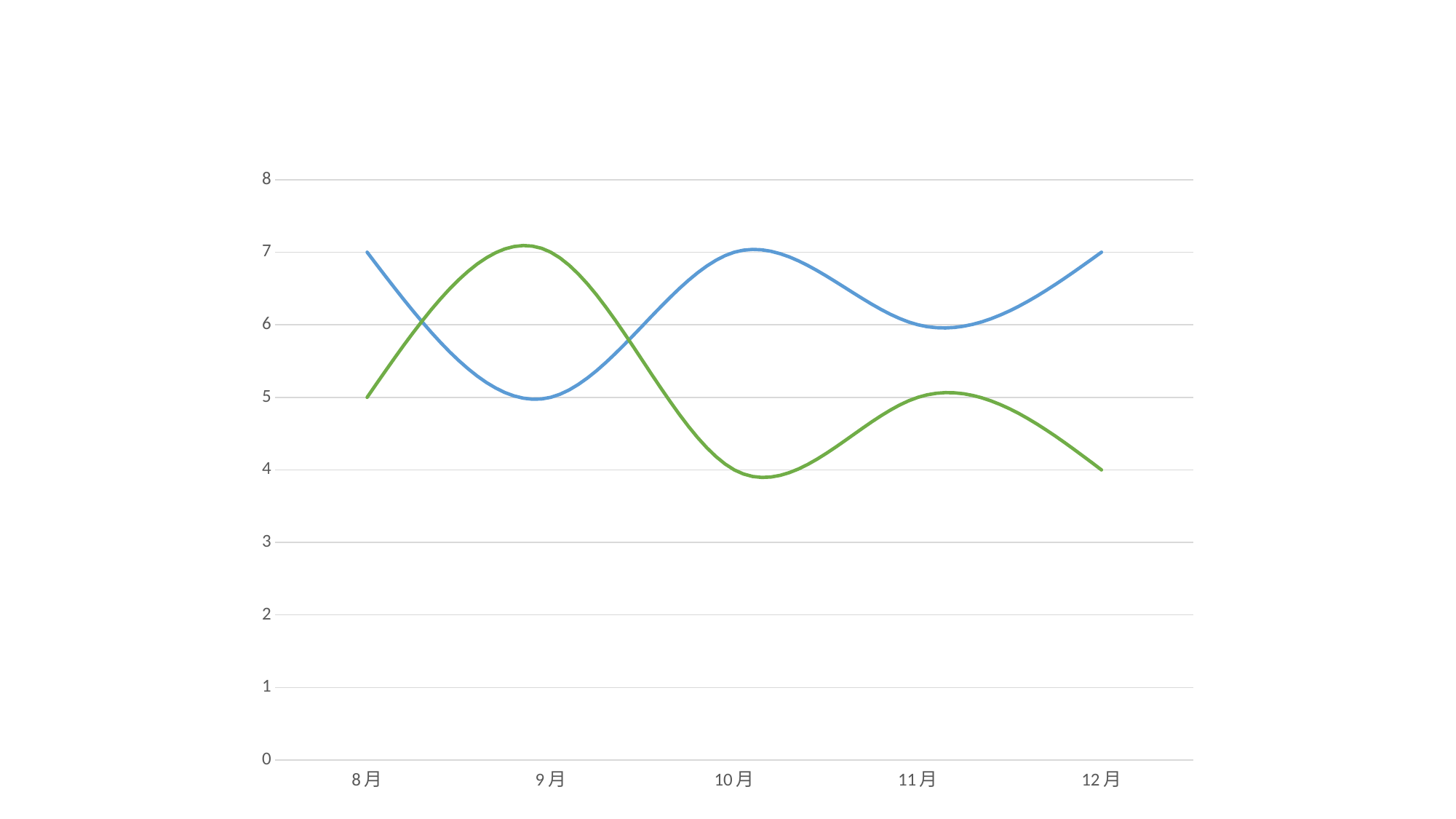
At which month does the green line reach its highest value? 9月 How many lines are plotted on the chart? 2 At which month does the blue line reach its lowest value? 9月 Which line has the larger value at 12月, the blue line or the green line? blue line Does the green line rise or fall from 11月 to 12月? fall What is the value of the green line at 10月? 4 What is the difference between the blue line and the green line at 12月? 3 What is the value of the blue line at 9月? 5 What is the value of the green line at 12月? 4 What is the value of the blue line at 8月? 7 How many categories are shown on the x axis? 5 What kind of chart is shown on the slide? line chart